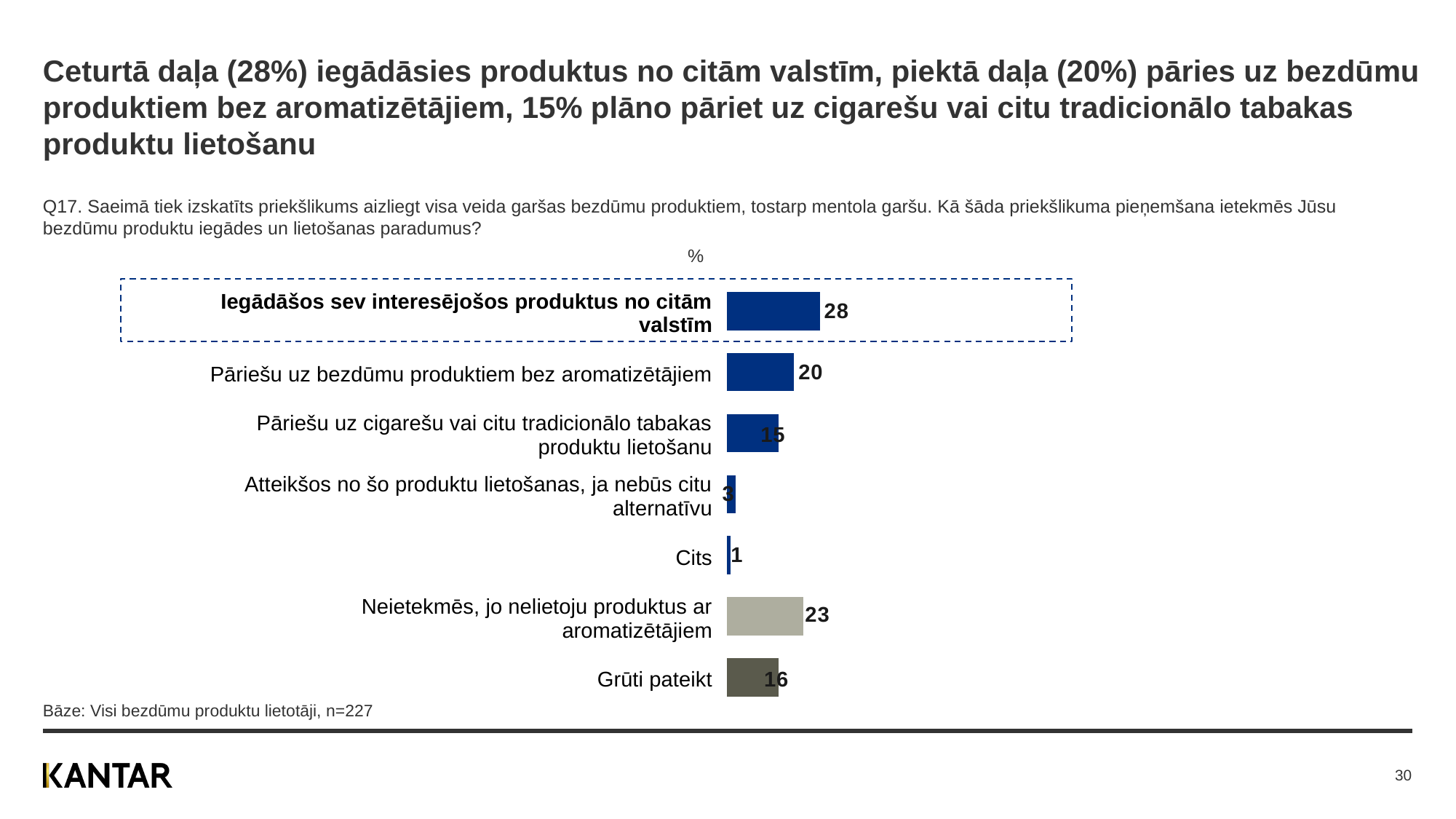
What is the base (n) stated below the chart? n=227 What is the value for "Grūti pateikt"? 16 What is the difference between the values for "Iegādāšos sev interesējošos produktus no citām valstīm" and "Pāriešu uz bezdūmu produktiem bez aromatizētājiem"? 8 Which category has the highest value? Iegādāšos sev interesējošos produktus no citām valstīm What is the value for "Cits"? 1 What kind of chart is shown on the slide? Bar chart Which is larger: the value for "Neietekmēs, jo nelietoju produktus ar aromatizētājiem" or the value for "Grūti pateikt"? Neietekmēs, jo nelietoju produktus ar aromatizētājiem What is the value for "Pāriešu uz bezdūmu produktiem bez aromatizētājiem"? 20 How many categories are shown in the chart? 7 Which category has the lowest value? Cits What is the value for "Iegādāšos sev interesējošos produktus no citām valstīm"? 28 What is the value for "Neietekmēs, jo nelietoju produktus ar aromatizētājiem"? 23